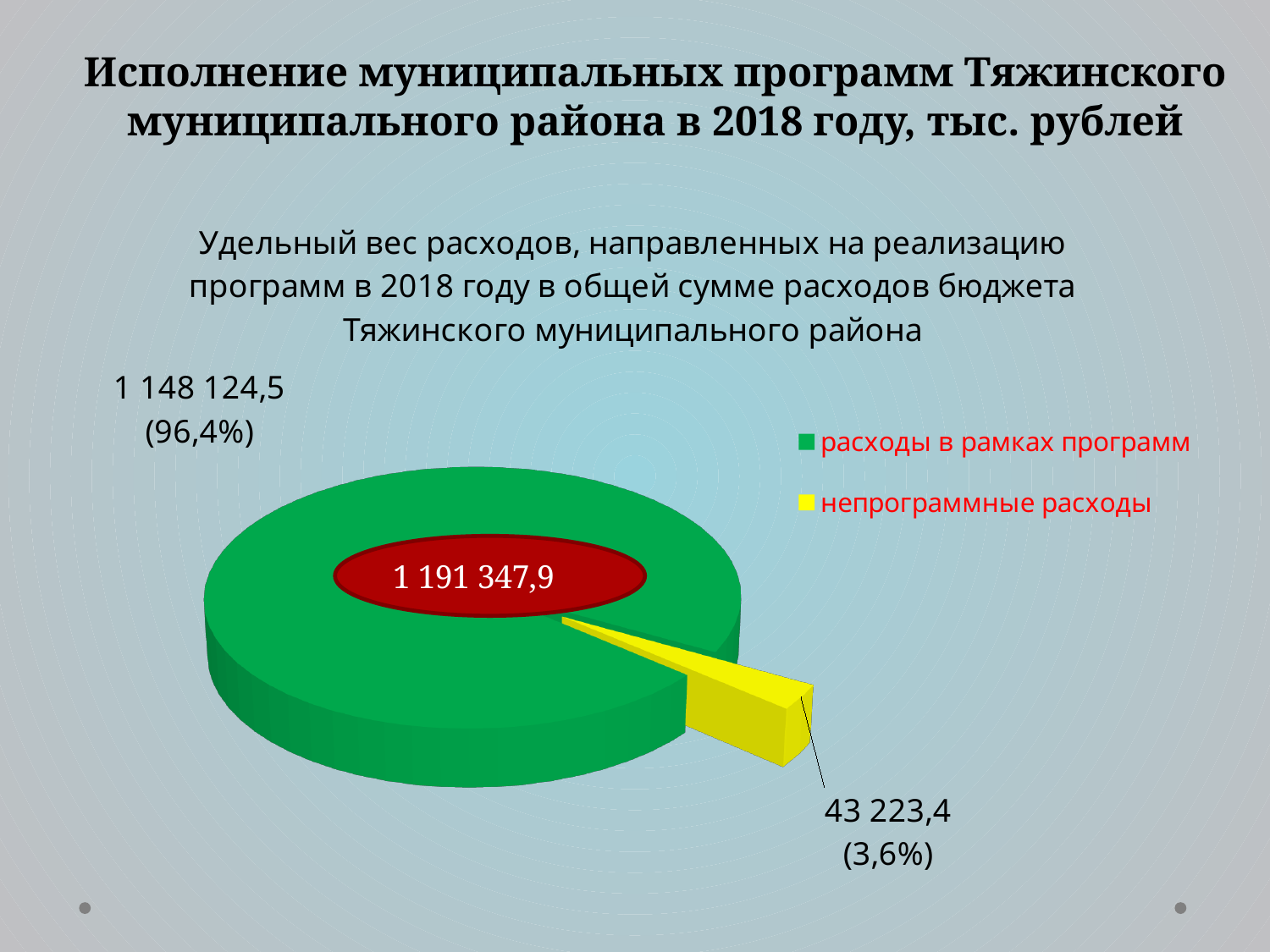
What share of the pie does «непрограммные расходы» represent? 3,6% What is the value for «непрограммные расходы»? 43 223,4 What share of the pie does «расходы в рамках программ» represent? 96,4% Which category has the smallest slice of the pie? непрограммные расходы What type of chart is shown on the slide? Pie chart What is the value for «расходы в рамках программ»? 1 148 124,5 Which category has the largest slice of the pie? расходы в рамках программ What is the difference between the values for «расходы в рамках программ» and «непрограммные расходы»? 1 104 901,1 What colour is the slice for «непрограммные расходы»? Yellow What total value is printed in the centre of the pie chart? 1 191 347,9 Which is larger: «расходы в рамках программ» or «непрограммные расходы»? расходы в рамках программ How many categories does the pie chart show? 2